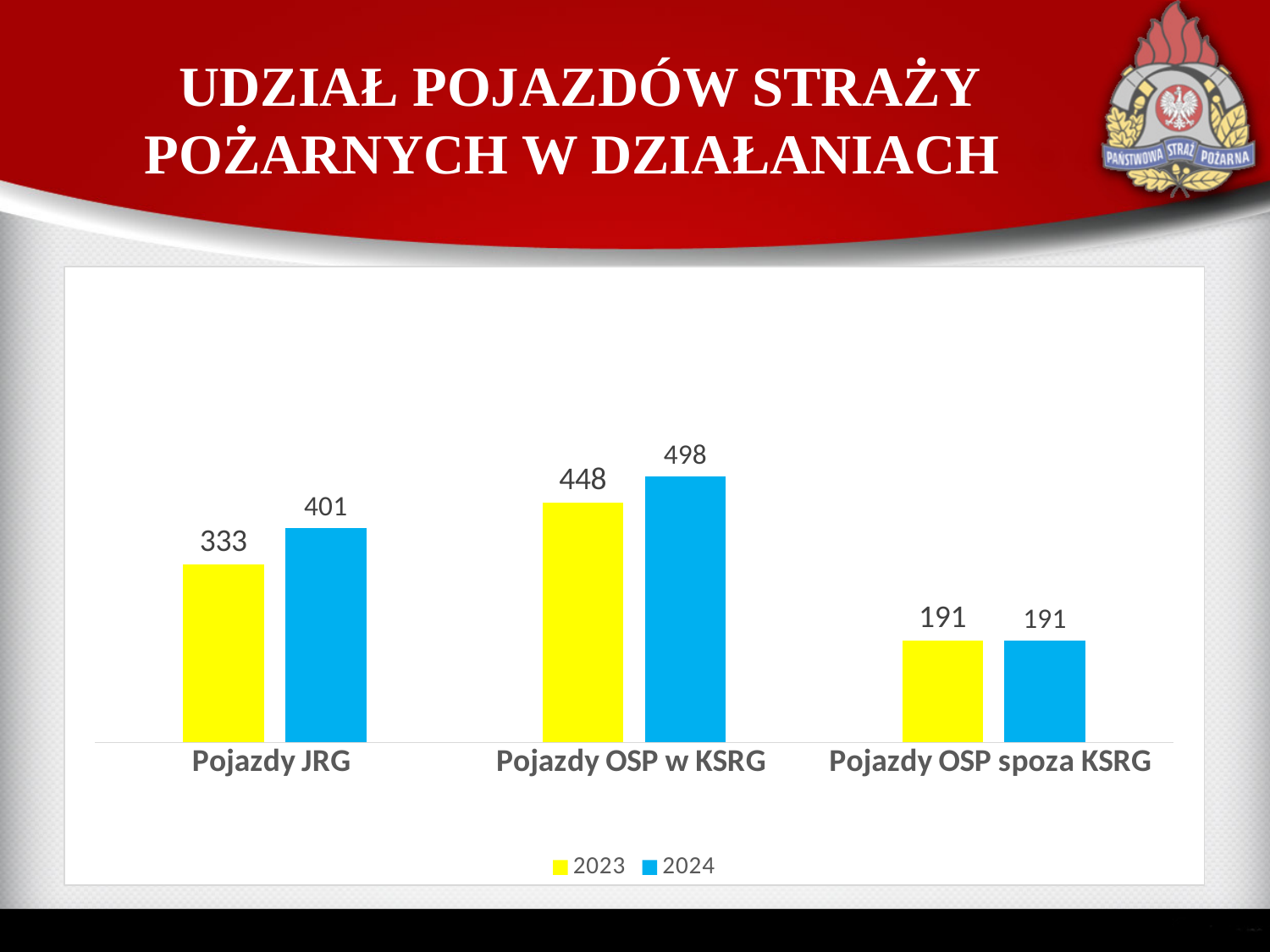
Which is larger for Pojazdy JRG: the 2023 value or the 2024 value? 2024 How many series does the legend list? 2 Which category has the lowest value in 2023? Pojazdy OSP spoza KSRG What is the value for Pojazdy OSP w KSRG in 2024? 498 What is the value for Pojazdy OSP spoza KSRG in 2023? 191 What is the difference between the 2024 and 2023 values for Pojazdy OSP w KSRG? 50 How many categories are shown on the x axis? 3 What kind of chart is shown on the slide? Bar chart What is the value for Pojazdy JRG in 2023? 333 Which category has the highest value in 2024? Pojazdy OSP w KSRG Which colour represents the 2024 series? Blue What is the difference between the 2024 and 2023 values for Pojazdy JRG? 68